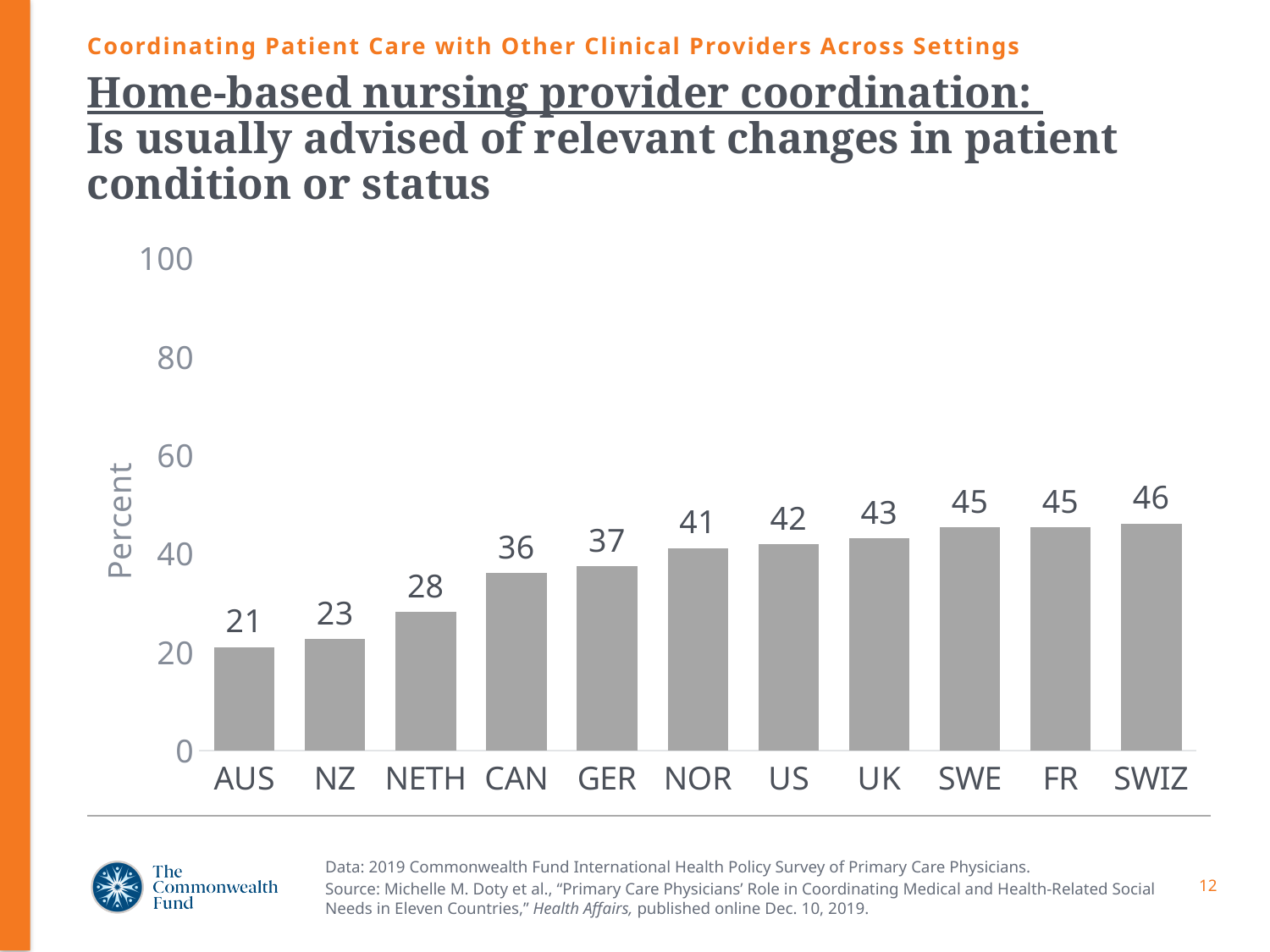
Do the values rise or fall from left to right along the x axis? rise Which is larger, the value for NOR or the value for NETH? NOR What is the difference between the values for CAN and NZ? 13 What kind of chart is shown on the slide? bar chart Which country has the lowest value? AUS What is the difference between the values for SWIZ and AUS? 25 What is the value for NETH? 28 What is the value for US? 42 How many countries are shown on the x axis? 11 Which country has the highest value? SWIZ Is the value for UK greater or less than 40? greater What is the value for GER? 37